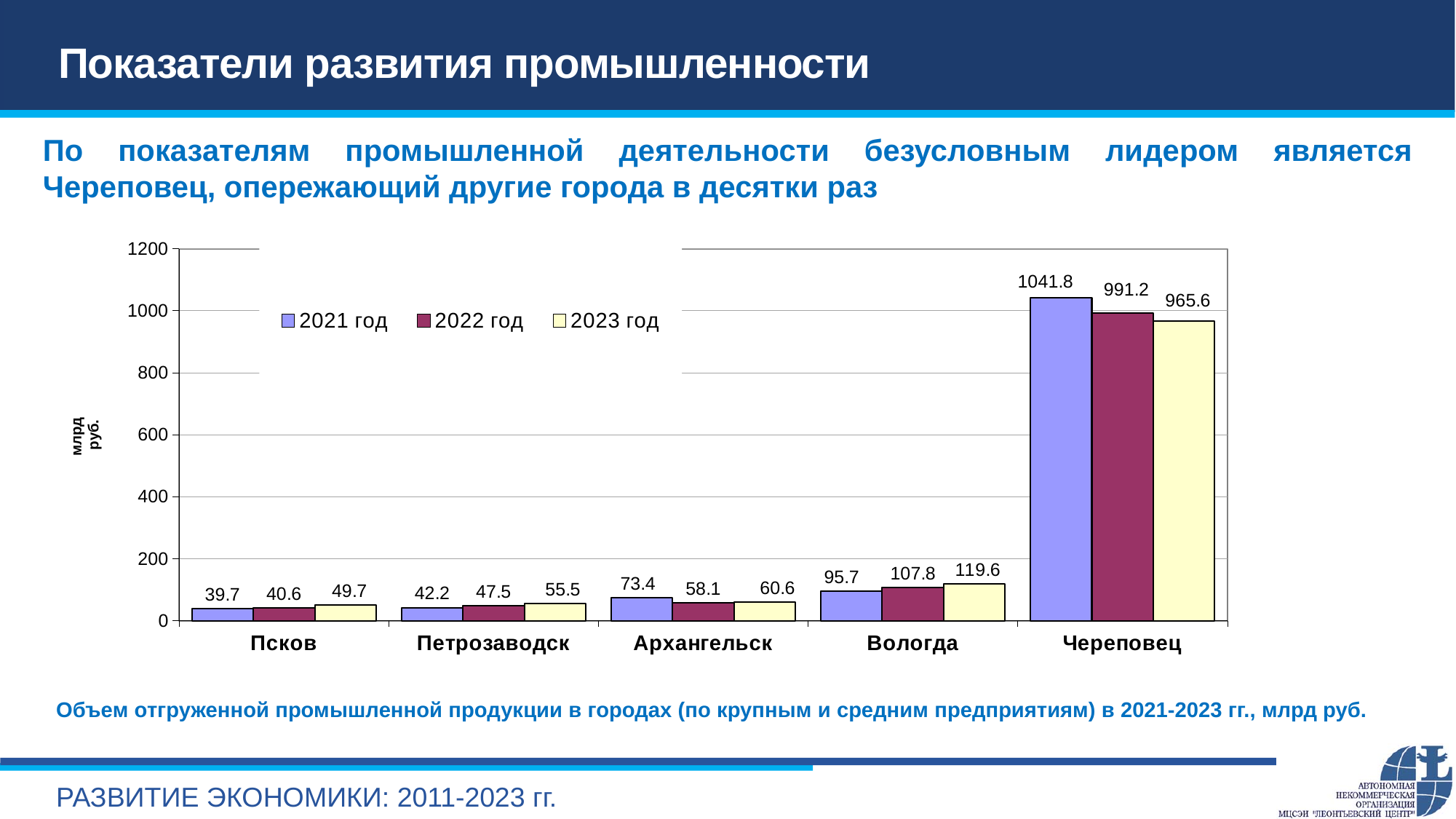
Which city has the lowest value in 2021 год? Псков What is the value for Вологда in 2023 год? 119.6 What is the difference between the 2021 год and 2023 год values for Череповец? 76.2 Do the values for Череповец rise or fall from 2021 год to 2023 год? fall Is the value for Вологда in 2022 год greater or less than 200? less What is the value for Череповец in 2021 год? 1041.8 How many series does the legend list? 3 What is the value for Архангельск in 2022 год? 58.1 What kind of chart is shown on the slide? bar chart Which is larger for Архангельск: the 2021 год value or the 2023 год value? 2021 год How many cities are shown on the x axis? 5 Which city has the highest value in 2023 год? Череповец